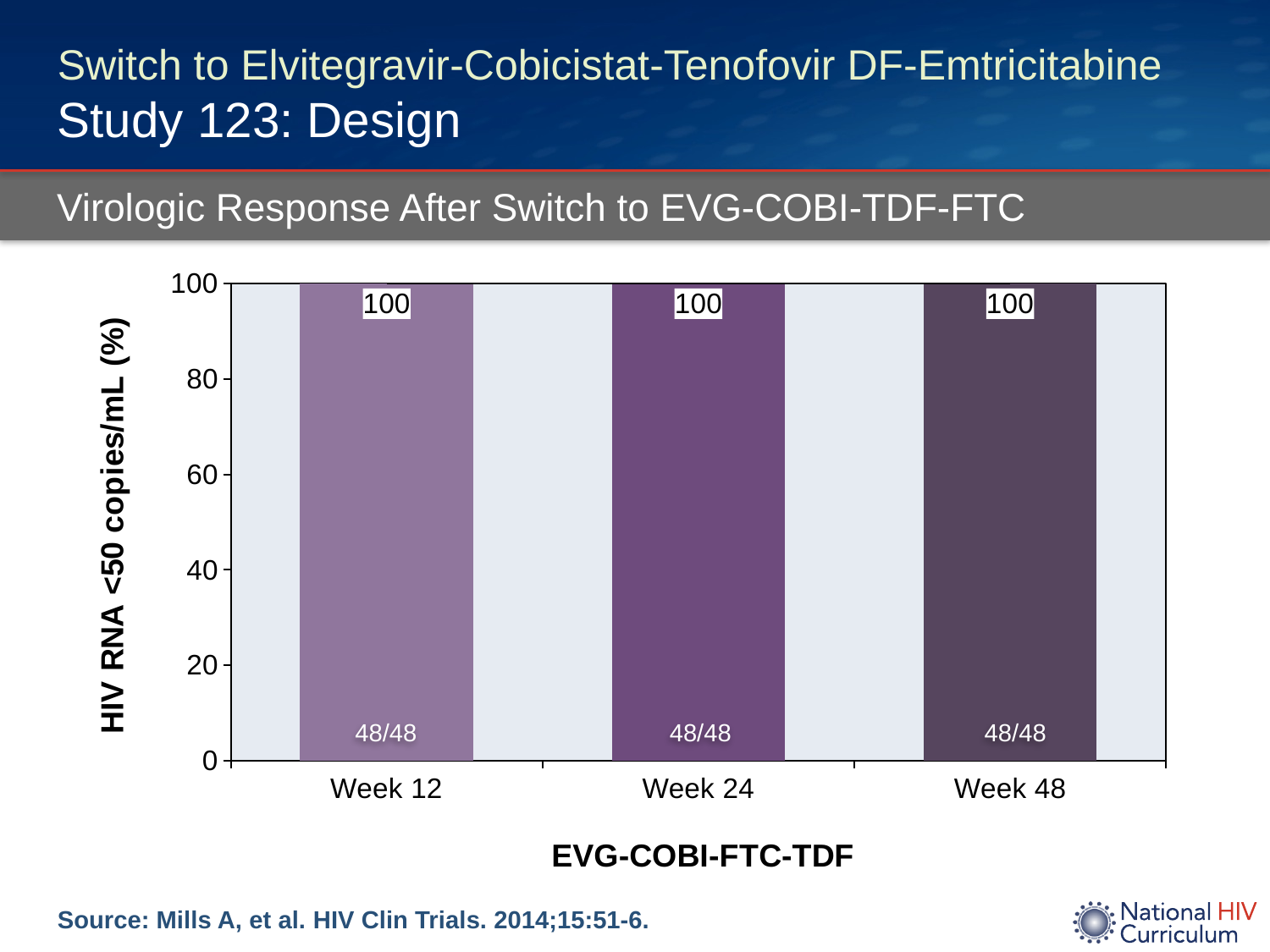
What regimen label appears below the x axis of the chart? EVG-COBI-FTC-TDF What fraction of participants is shown inside the Week 12 bar? 48/48 Is the value for Week 24 greater or less than 80? greater What kind of chart is shown on the slide? Bar chart What fraction of participants is shown inside the Week 48 bar? 48/48 What is the difference between the values for Week 12 and Week 48? 0 What is the value for Week 12? 100 What is the label on the y axis of the chart? HIV RNA <50 copies/mL (%) What is the value for Week 48? 100 Do the values rise, fall, or stay the same from Week 12 to Week 48? Stay the same What is the value for Week 24? 100 How many time points are shown on the x axis? 3